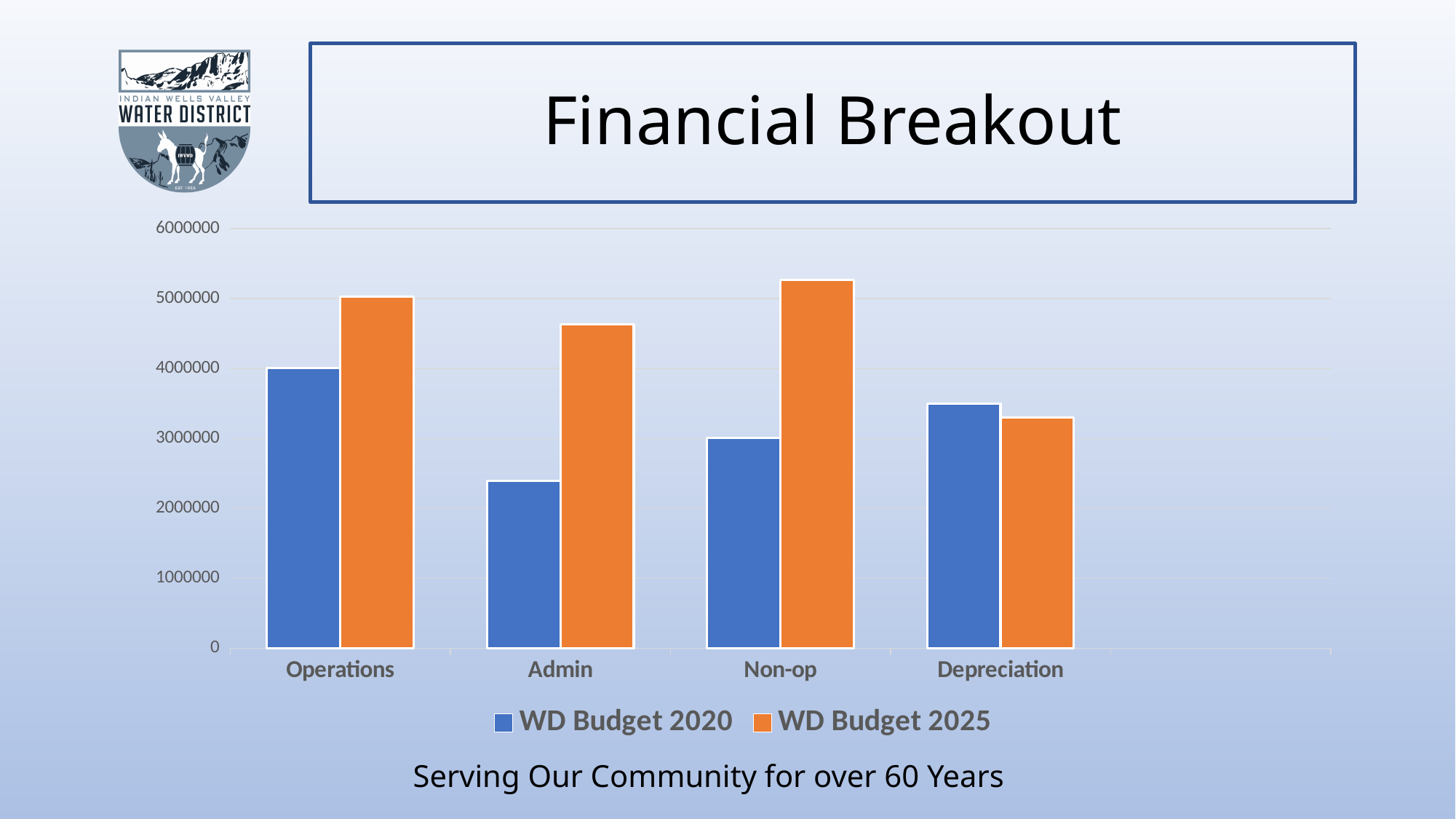
Is the WD Budget 2025 value for Non-op greater or less than 5000000? greater Which category has the highest WD Budget 2025 value? Non-op Is the WD Budget 2025 value for Admin greater or less than 4000000? greater Is the WD Budget 2020 value for Admin greater or less than 3000000? less Which category has the lowest WD Budget 2025 value? Depreciation Which category has the highest WD Budget 2020 value? Operations What kind of chart is shown on the slide? bar chart How many categories are shown on the x axis of the chart? 4 Which series is shown in orange in the chart's legend? WD Budget 2025 How many series does the chart's legend list? 2 For Depreciation, which is larger: WD Budget 2020 or WD Budget 2025? WD Budget 2020 Which category has the lowest WD Budget 2020 value? Admin